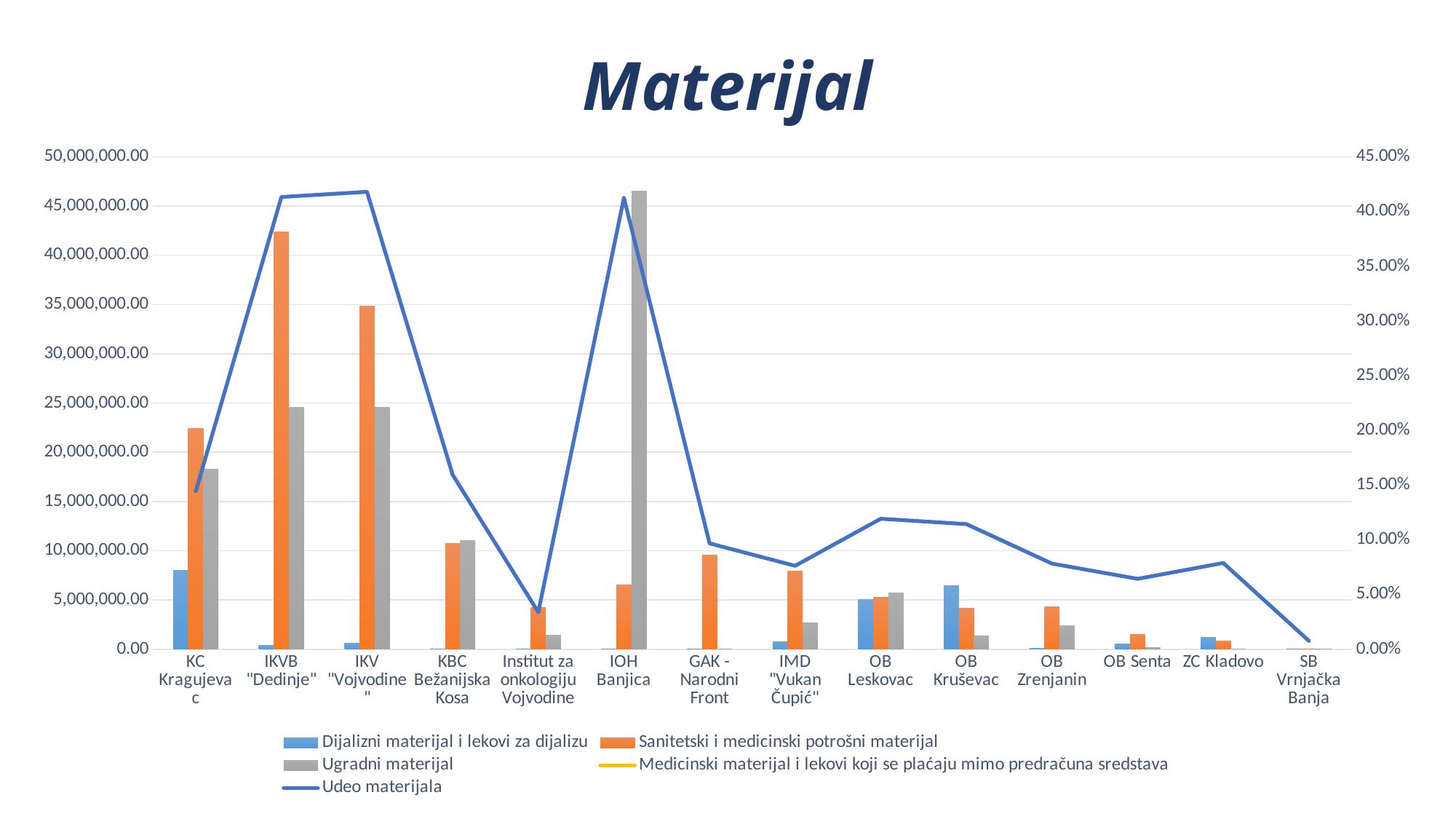
How many series does the legend list? 5 Is the Sanitetski i medicinski potrošni materijal value for IKVB "Dedinje" greater or less than 40,000,000.00? greater For IOH Banjica, which is larger: the Ugradni materijal value or the Sanitetski i medicinski potrošni materijal value? Ugradni materijal Which category has the highest value for the Sanitetski i medicinski potrošni materijal series? IKVB "Dedinje" Which category has the highest value for the Ugradni materijal series? IOH Banjica Which category has the highest value for the Dijalizni materijal i lekovi za dijalizu series? KC Kragujevac Is the Ugradni materijal value for IOH Banjica greater or less than 45,000,000.00? greater What is the title of the chart? Materijal Is the Udeo materijala value for SB Vrnjačka Banja greater or less than 5.00%? less Which is larger: the Sanitetski i medicinski potrošni materijal value for IKVB "Dedinje" or for IKV "Vojvodine"? IKVB "Dedinje" How many categories are shown on the x axis? 14